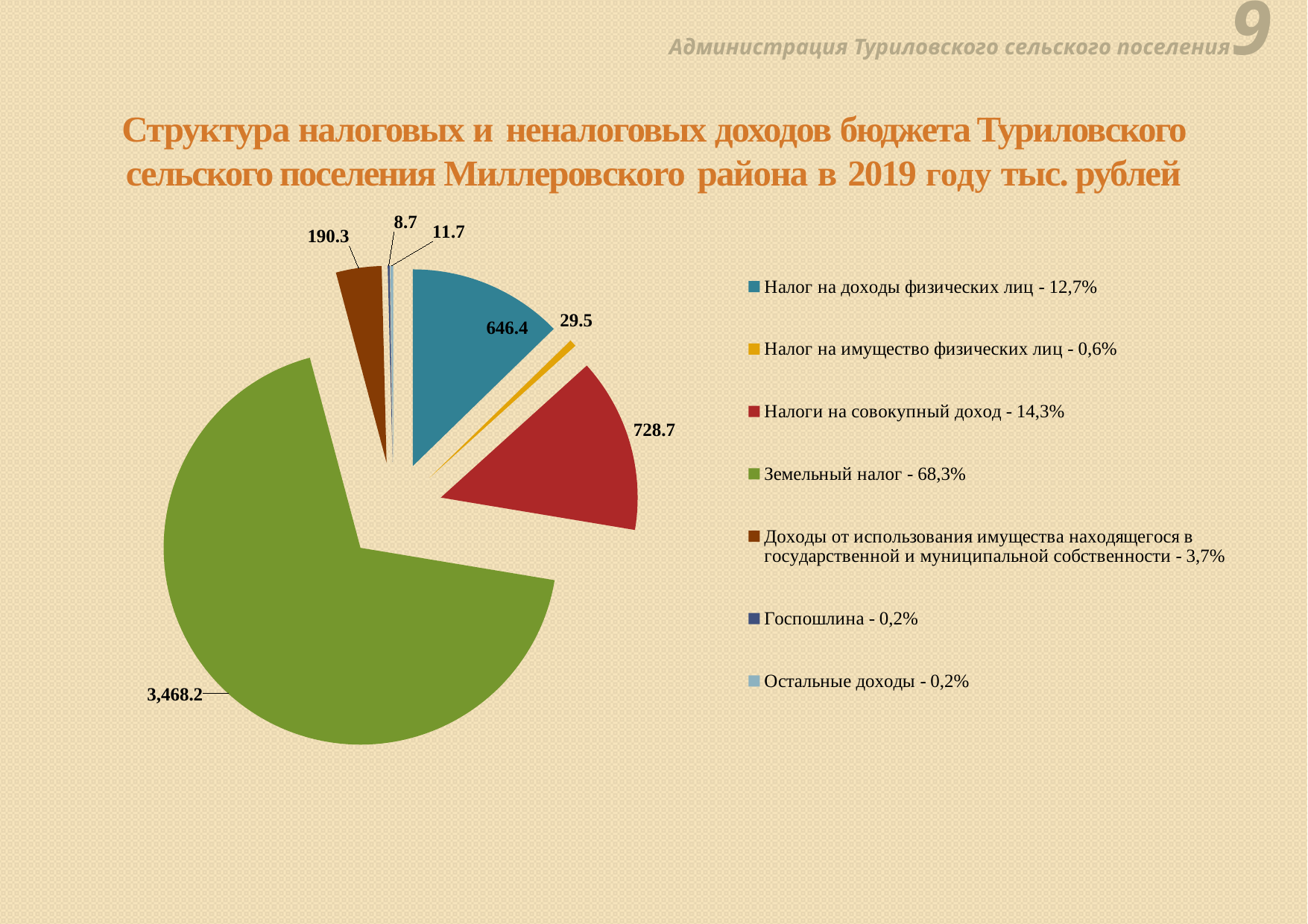
What is the value for Доходы от использования имущества находящегося в государственной и муниципальной собственности? 190.3 Which is larger: the value for Налог на имущество физических лиц or the value for Остальные доходы? Налог на имущество физических лиц How many categories does the legend list? 7 What is the value for Земельный налог? 3,468.2 Which category has the smallest slice of the pie? Госпошлина What share of the pie does Земельный налог represent, according to the legend? 68,3% Which category has the largest slice of the pie? Земельный налог What is the value for Налоги на совокупный доход? 728.7 What is the difference between the values for Налоги на совокупный доход and Налог на доходы физических лиц? 82.3 What is the value for Налог на доходы физических лиц? 646.4 What type of chart is shown on the slide? Pie chart What is the value for Госпошлина? 8.7